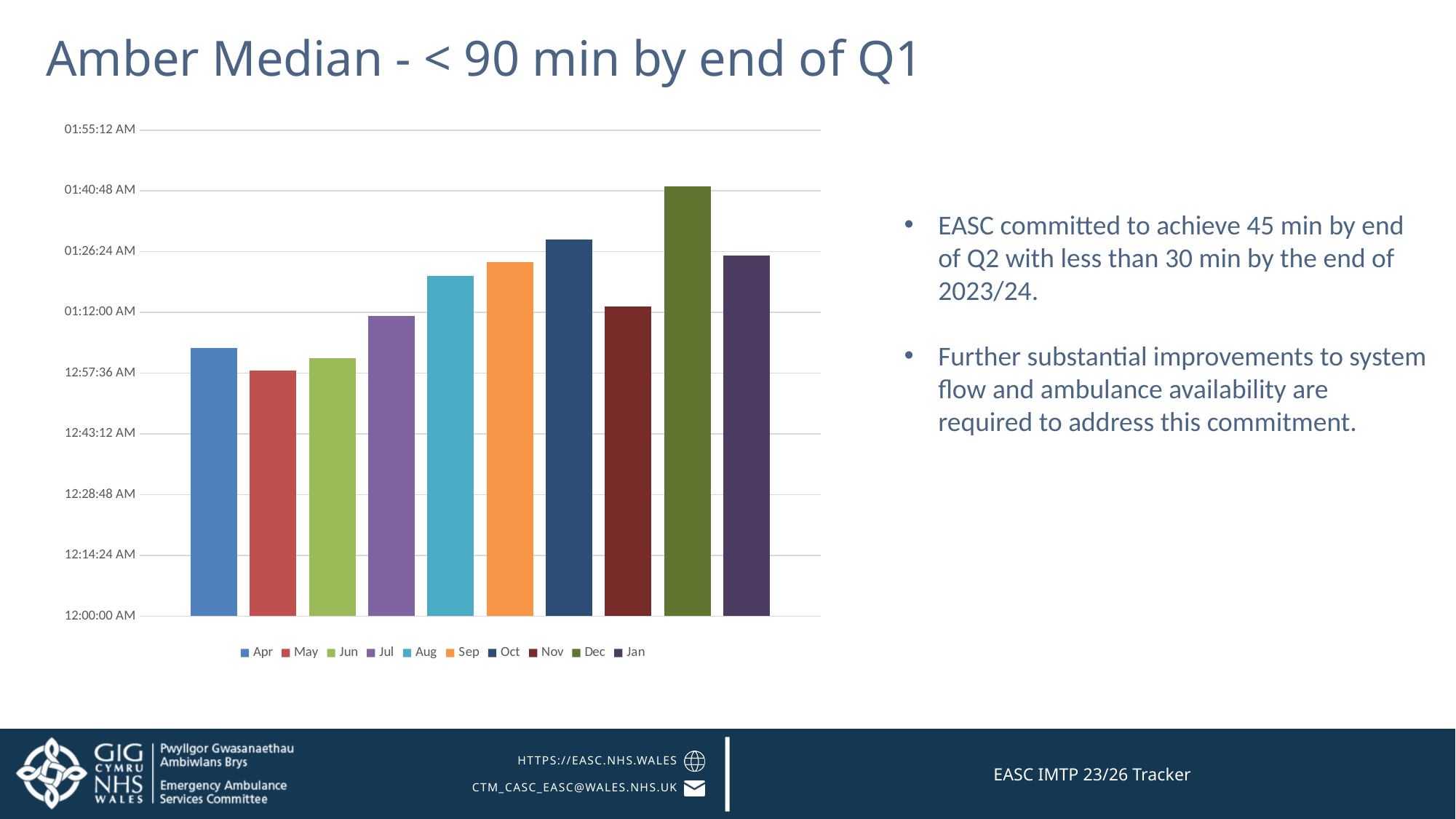
What is the title of the slide containing the chart? Amber Median - < 90 min by end of Q1 What kind of chart is shown on the slide? bar chart Is the value for Oct greater or less than 01:26:24 AM? greater How many entries does the chart legend list? 10 How many bars (months) are plotted in the chart? 10 Which is larger, the value for Dec or the value for Nov? Dec Is the value for Sep greater or less than 01:26:24 AM? less Is the value for May greater or less than 01:12:00 AM? less Which is larger, the value for Aug or the value for Apr? Aug Which month has the lowest bar in the chart? May Which month has the highest bar in the chart? Dec